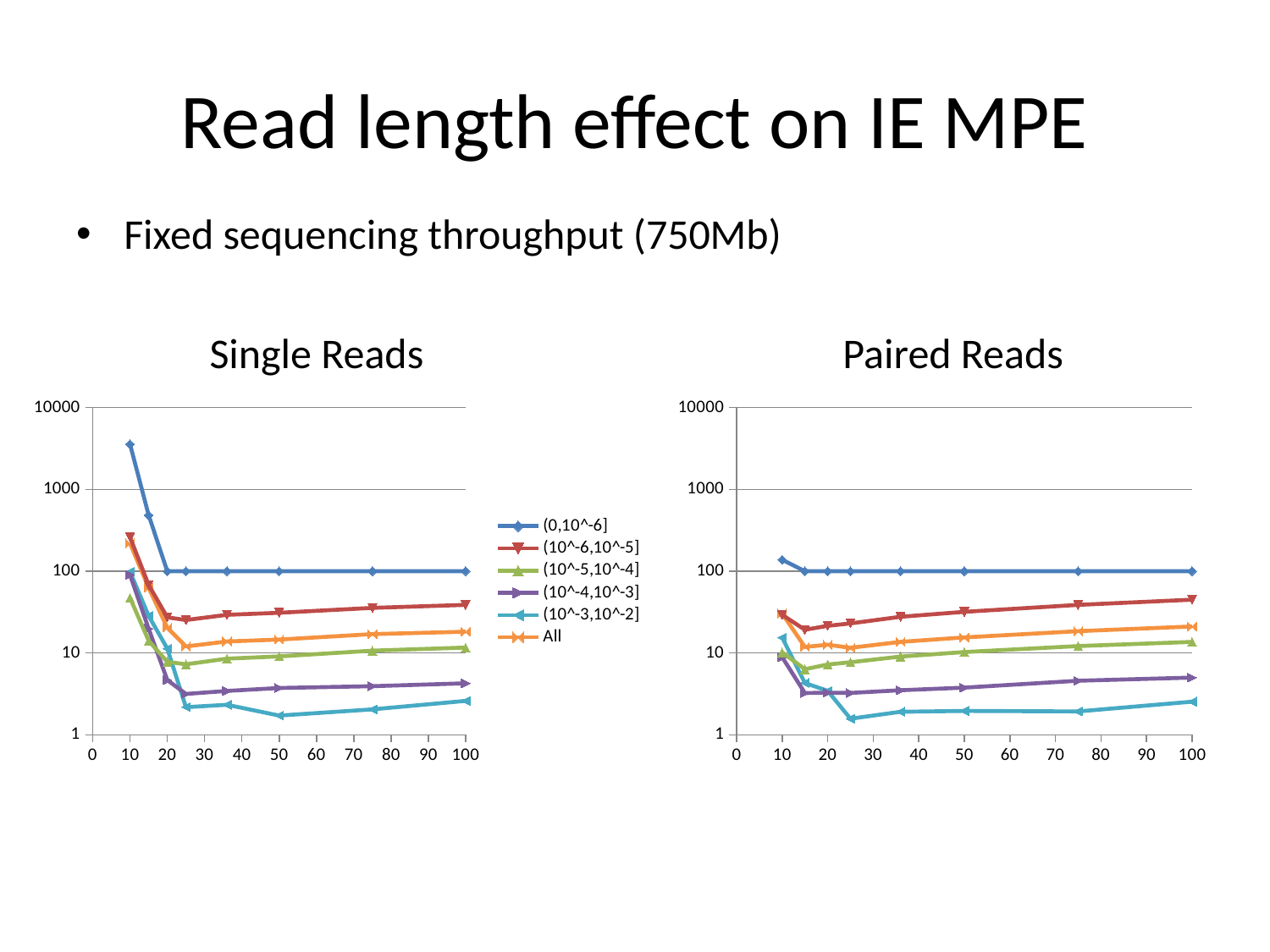
In the Paired Reads chart, which series has the lowest value at x = 100? (10^-3,10^-2] In the Single Reads chart, is the value of the (0,10^-6] series at x = 10 greater or less than 1000? greater In the Single Reads chart, does the (0,10^-6] series rise or fall between x = 10 and x = 20? fall How many series does the legend list? 6 In the Paired Reads chart, is the value of the (10^-6,10^-5] series at x = 100 greater or less than 100? less What kind of chart is the Single Reads chart? line chart In the Paired Reads chart, is the value of the (0,10^-6] series at x = 10 greater or less than 1000? less In the Single Reads chart, which series has the highest value at x = 10? (0,10^-6] What is the title of the chart on the left of the slide? Single Reads In the Paired Reads chart, which series has the highest value at x = 50? (0,10^-6] In the Single Reads chart, at x = 10, which is larger: the (0,10^-6] series or the (10^-6,10^-5] series? (0,10^-6]